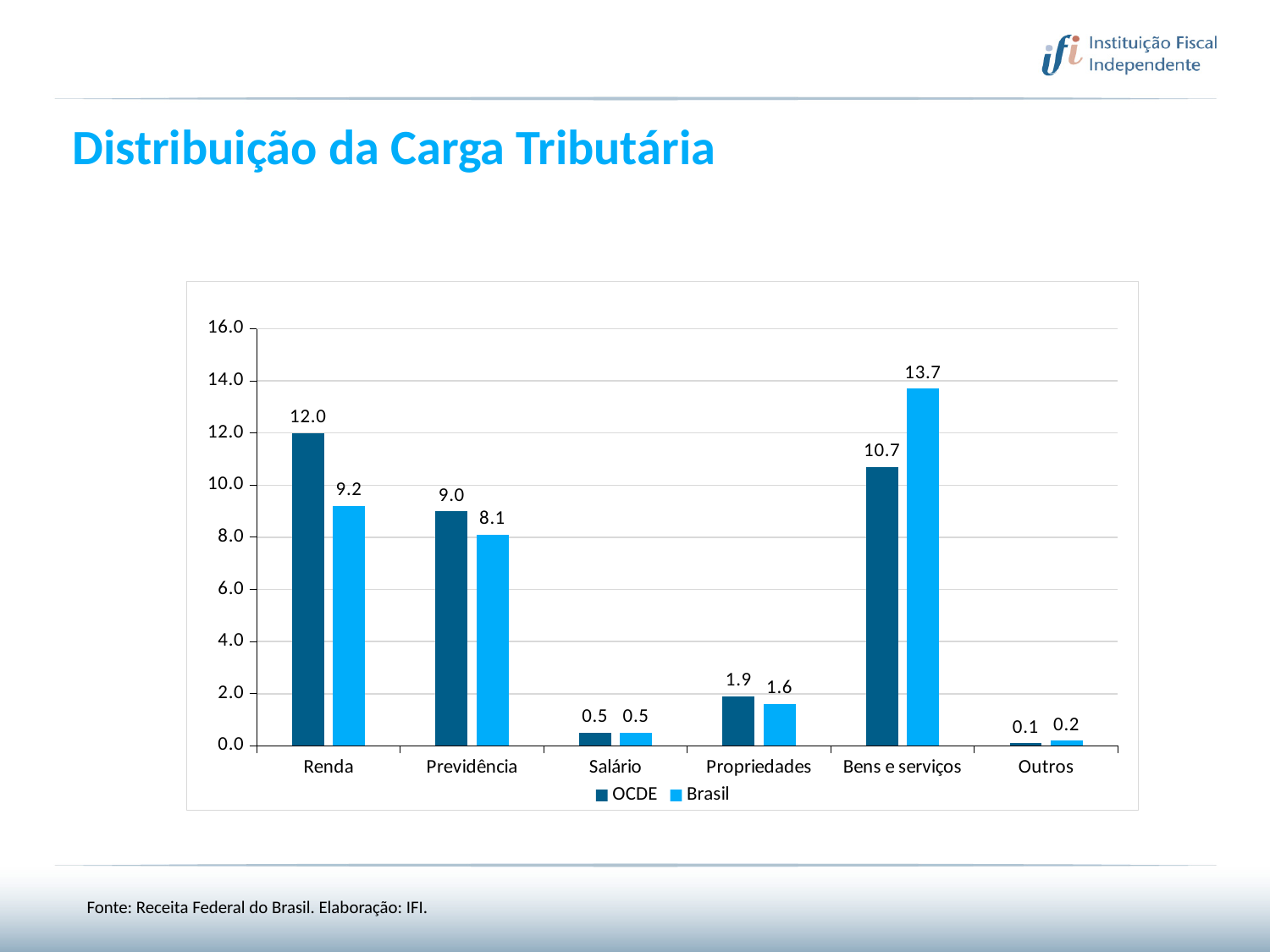
Which category has the highest Brasil value? Bens e serviços What is the OCDE value for Renda? 12.0 What is the Brasil value for Previdência? 8.1 Is the OCDE value for Previdência greater or less than 8.0? greater What kind of chart is shown on the slide? bar chart Which is larger for Bens e serviços, the OCDE value or the Brasil value? Brasil Which category has the lowest OCDE value? Outros How many categories are shown on the x axis? 6 What is the title of the slide? Distribuição da Carga Tributária How many series does the legend list? 2 What is the Brasil value for Bens e serviços? 13.7 What is the difference between the OCDE and Brasil values for Renda? 2.8